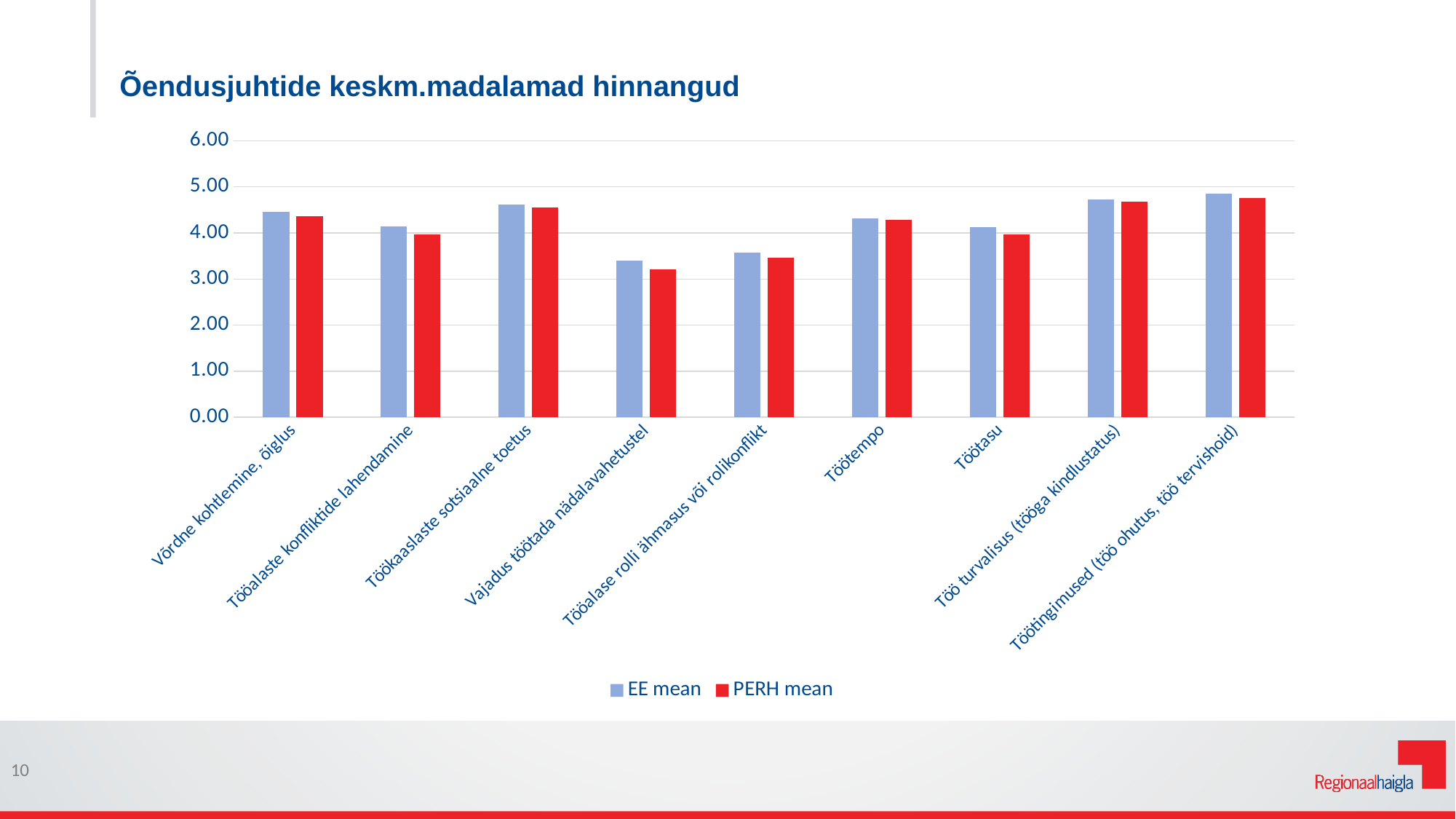
For Vajadus töötada nädalavahetustel, which is larger: the EE mean or the PERH mean? EE mean How many categories are shown on the x axis of the chart? 9 What are the two series named in the legend? EE mean and PERH mean Which category has the lowest EE mean value? Vajadus töötada nädalavahetustel Is the EE mean value for Tööalase rolli ähmasus või rollikonflikt greater or less than 4.00? less Is the EE mean value for Töötingimused (töö ohutus, töö tervishoid) greater or less than 4.00? greater How many series does the legend list? 2 What is the title of the slide? Õendusjuhtide keskm.madalamad hinnangud For Töötasu, which is larger: the EE mean or the PERH mean? EE mean What kind of chart is shown on the slide? bar chart Which category has the highest EE mean value? Töötingimused (töö ohutus, töö tervishoid) Is the PERH mean value for Vajadus töötada nädalavahetustel greater or less than 4.00? less